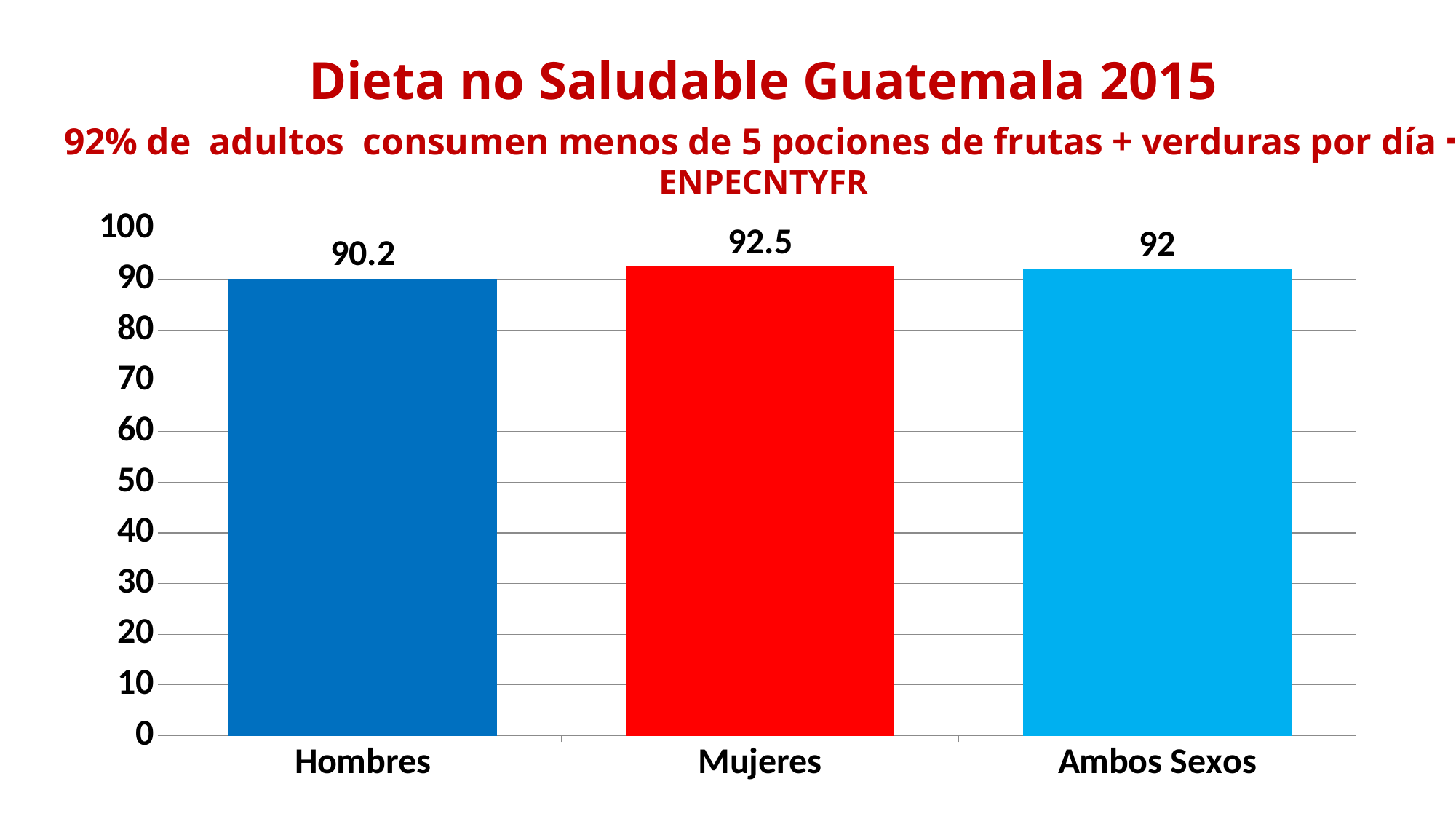
Which category has the lowest value? Hombres Which is larger, the value for Mujeres or the value for Hombres? Mujeres How many categories are shown on the x axis? 3 What is the difference between the values for Mujeres and Hombres? 2.3 What is the value for Hombres? 90.2 What is the title of the slide? Dieta no Saludable Guatemala 2015 Is the value for Hombres greater or less than 80? greater Which category has the highest value? Mujeres What is the value for Ambos Sexos? 92 What kind of chart is shown on the slide? bar chart What is the difference between the values for Ambos Sexos and Hombres? 1.8 What is the value for Mujeres? 92.5